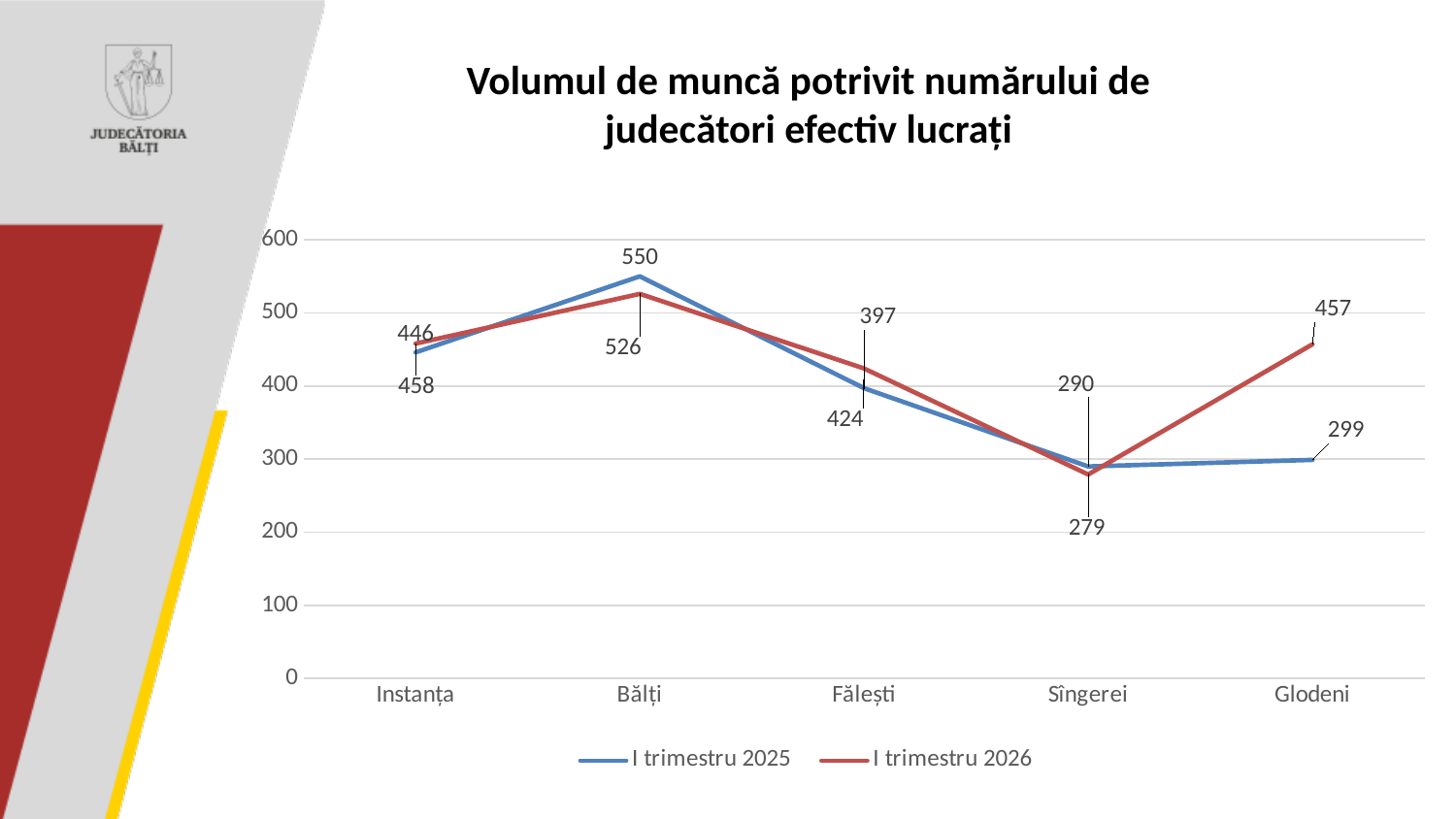
Is the value for Sîngerei in the I trimestru 2026 series greater or less than 300? less What is the value for Fălești in the I trimestru 2026 series? 424 What is the difference between the I trimestru 2026 and I trimestru 2025 values for Glodeni? 158 For Bălți, which series has the larger value, I trimestru 2025 or I trimestru 2026? I trimestru 2025 How many categories are shown on the x axis? 5 How many series does the legend list? 2 What kind of chart is shown on the slide? line chart Which category has the lowest value in the I trimestru 2026 series? Sîngerei What is the value for Bălți in the I trimestru 2025 series? 550 What is the value for Glodeni in the I trimestru 2026 series? 457 Does the I trimestru 2025 series rise or fall from Bălți to Sîngerei? fall Which category has the highest value in the I trimestru 2025 series? Bălți